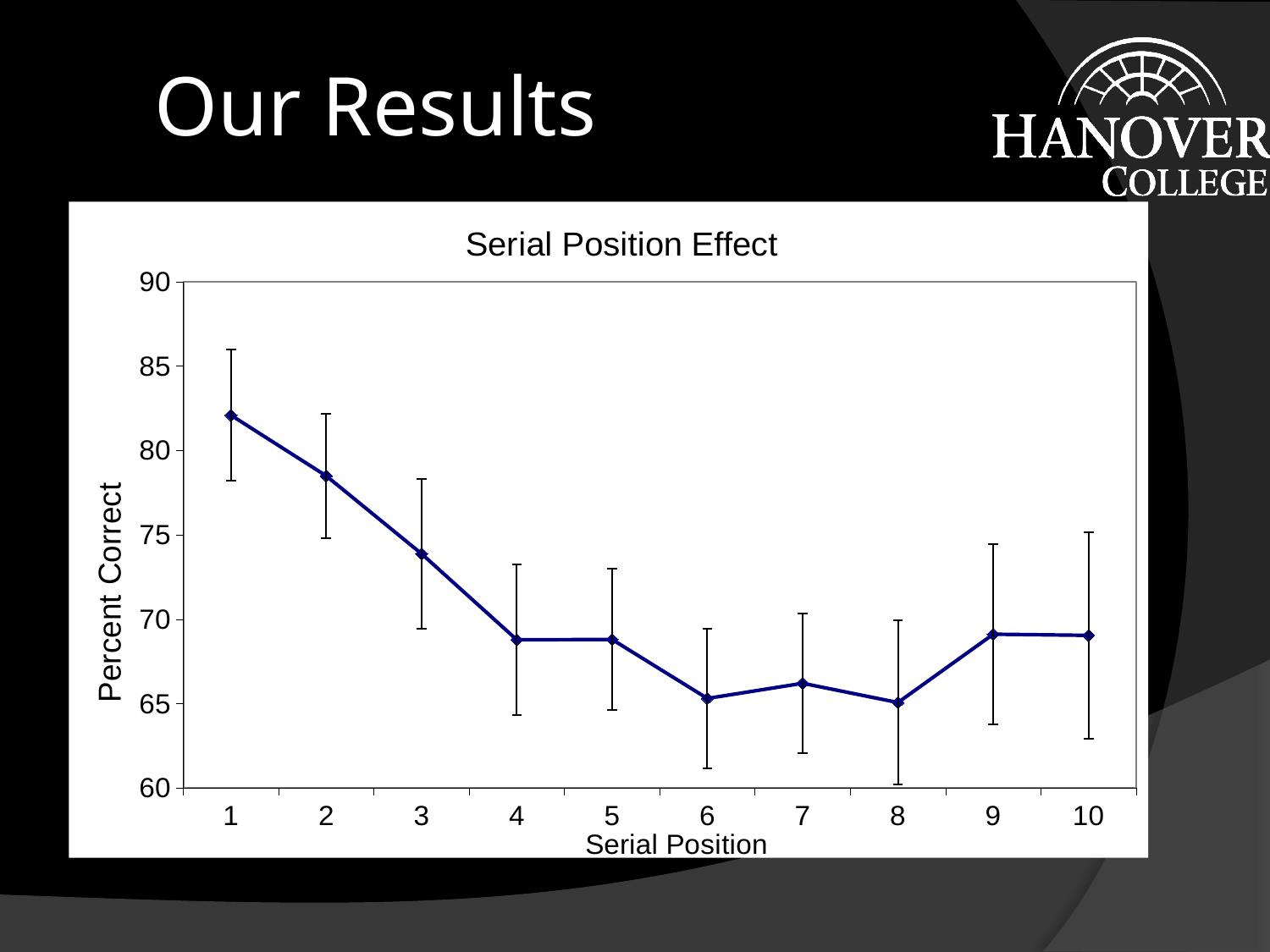
Is the percent correct for serial position 1 greater or less than 80? greater Which has a higher percent correct, serial position 1 or serial position 10? serial position 1 Does the percent correct rise or fall from serial position 1 to serial position 6? fall What is the label on the vertical axis of the chart? Percent Correct What is the title of the chart? Serial Position Effect Which has a higher percent correct, serial position 3 or serial position 6? serial position 3 What kind of chart is shown on the slide? line chart Is the percent correct for serial position 6 greater or less than 70? less How many serial positions are plotted on the x axis? 10 Is the percent correct for serial position 3 greater or less than 75? less Which serial position has the highest percent correct? 1